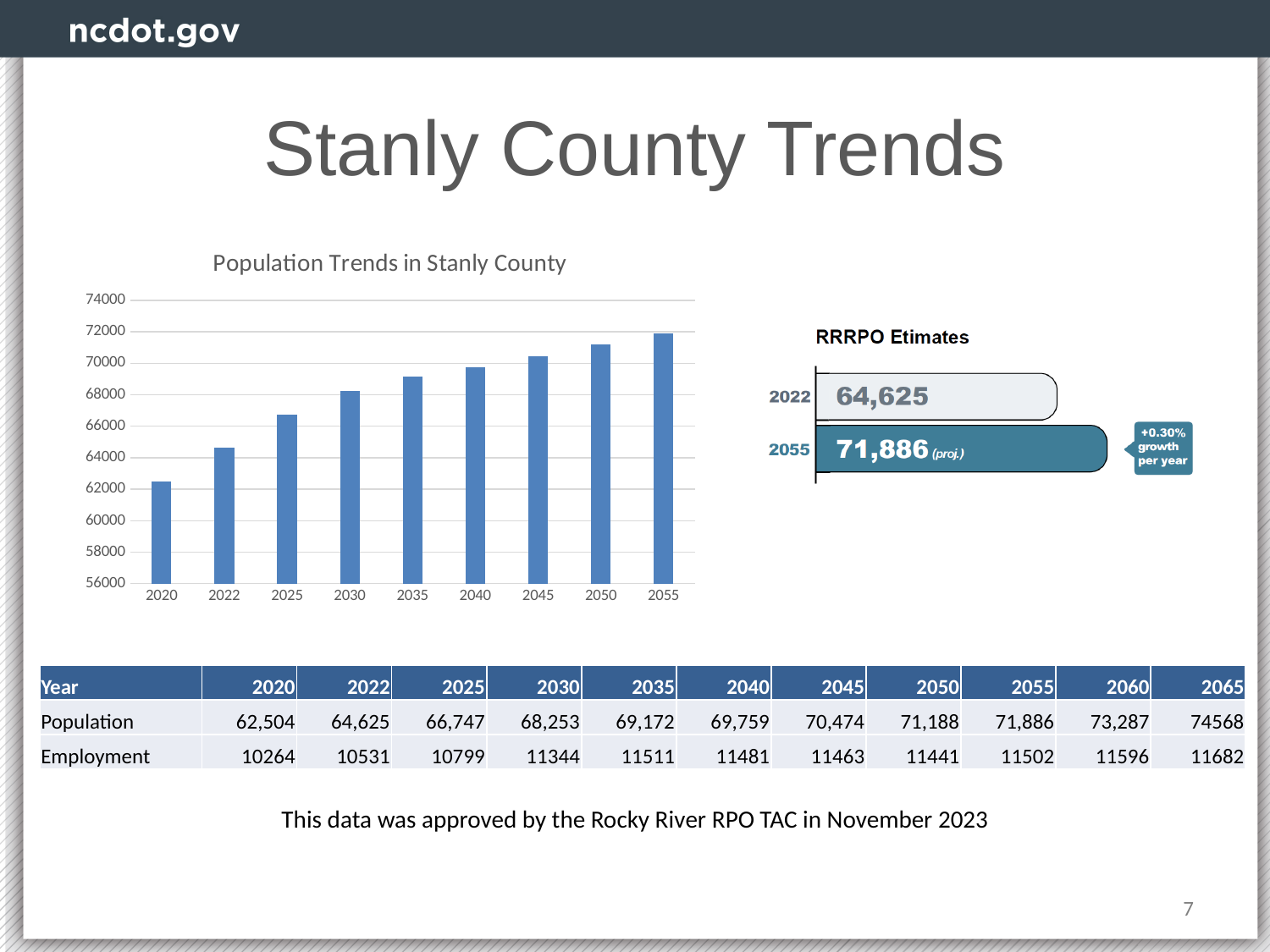
In the Population Trends in Stanly County chart, is the value for 2020 greater or less than 64000? less What kind of chart is used to show Population Trends in Stanly County? bar chart What is the population of Stanly County in 2022 according to the slide? 64,625 In the Population Trends in Stanly County chart, do the values rise or fall from 2020 to 2055? rise In the Population Trends in Stanly County chart, which year has the lowest population? 2020 By how much does the Stanly County population grow from 2022 to 2055 according to the values printed on the slide? 7,261 What is the projected population of Stanly County in 2055 according to the slide? 71,886 In the Population Trends in Stanly County chart, is the value for 2055 greater or less than 70000? greater How many years (bars) are plotted in the Population Trends in Stanly County chart? 9 In the Population Trends in Stanly County chart, which year has the highest population? 2055 What is the title of the bar chart on the slide? Population Trends in Stanly County In the Population Trends in Stanly County chart, which year has the larger population, 2025 or 2030? 2030